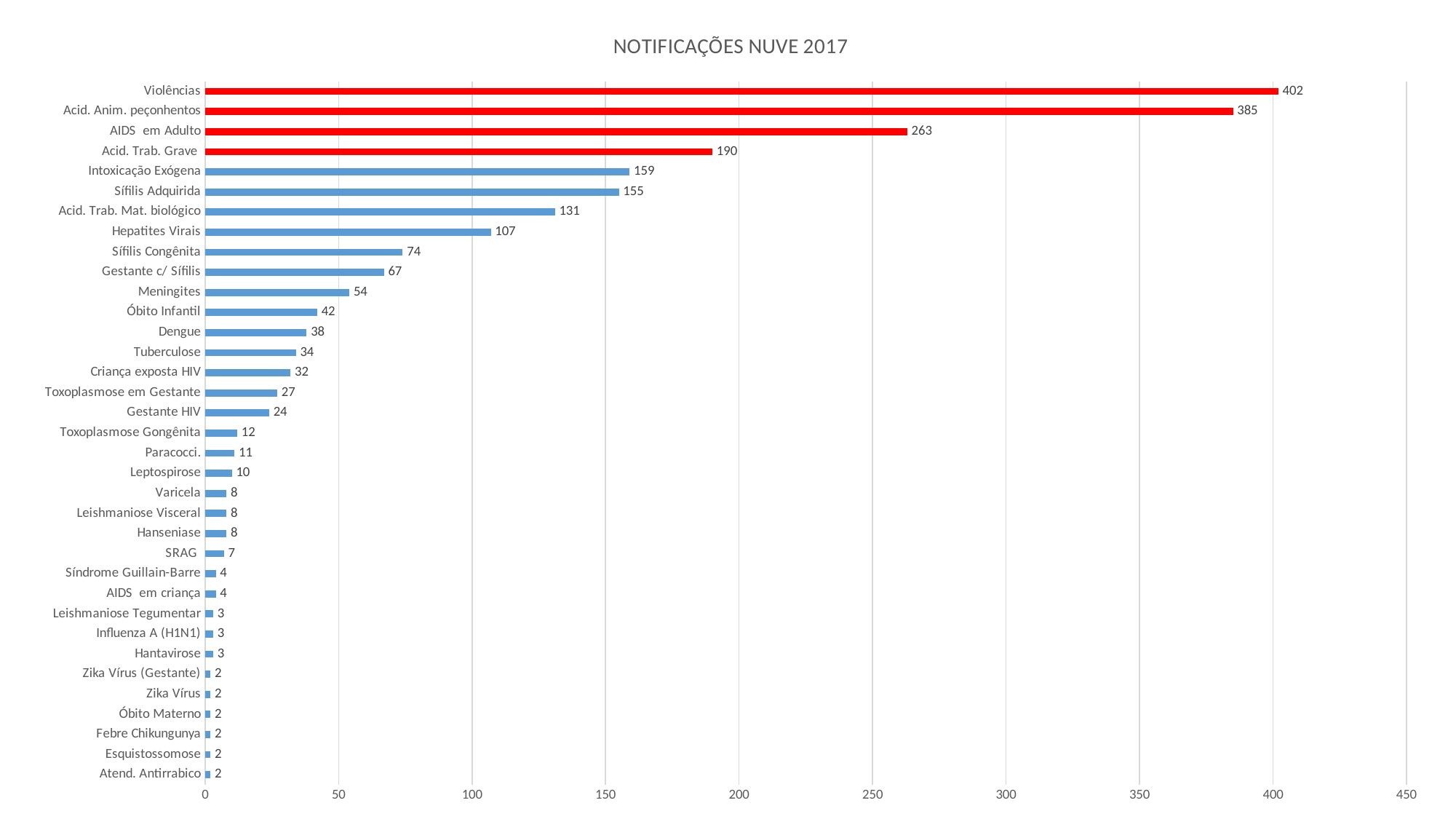
What is the title of the chart? NOTIFICAÇÕES NUVE 2017 What is the value for Violências? 402 What kind of chart is shown on the slide? bar chart What is the value for Acid. Trab. Mat. biológico? 131 Which category has the highest value? Violências Which is larger, the value for Hepatites Virais or the value for Sífilis Congênita? Hepatites Virais What is the difference between the values for Violências and Acid. Anim. peçonhentos? 17 What is the difference between the values for AIDS em Adulto and Acid. Trab. Grave? 73 What is the value for Dengue? 38 What is the value for Leptospirose? 10 Is the value for Intoxicação Exógena greater or less than 150? greater How many categories are shown in the chart? 35